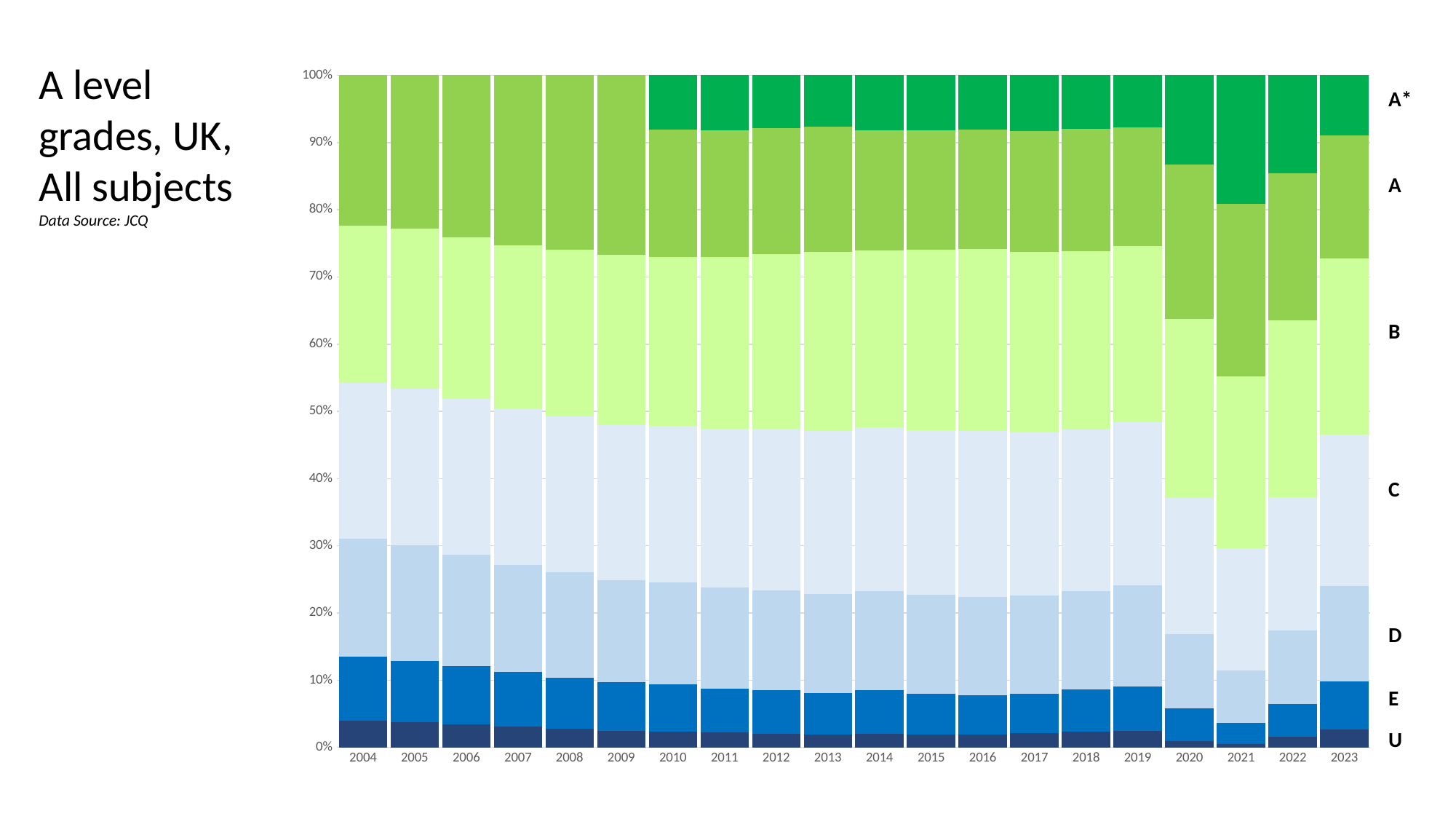
What data source is cited for the chart? JCQ In which year does the A* grade first appear in the chart? 2010 Does the share of grade U rise or fall from 2004 to 2019? fall Which year has the largest share of A* grades? 2021 What is the title of the chart? A level grades, UK, All subjects Which year has the larger share of A* grades, 2019 or 2021? 2021 Which year has the smallest share of grade C? 2021 What kind of chart is shown on the slide? Stacked bar chart Is the share of grade U in 2004 greater or less than 10%? less How many grade categories are labelled on the right of the chart? 7 How many years are shown along the x axis of the chart? 20 In 2021, is the combined share of A* and A grades greater or less than 40%? greater